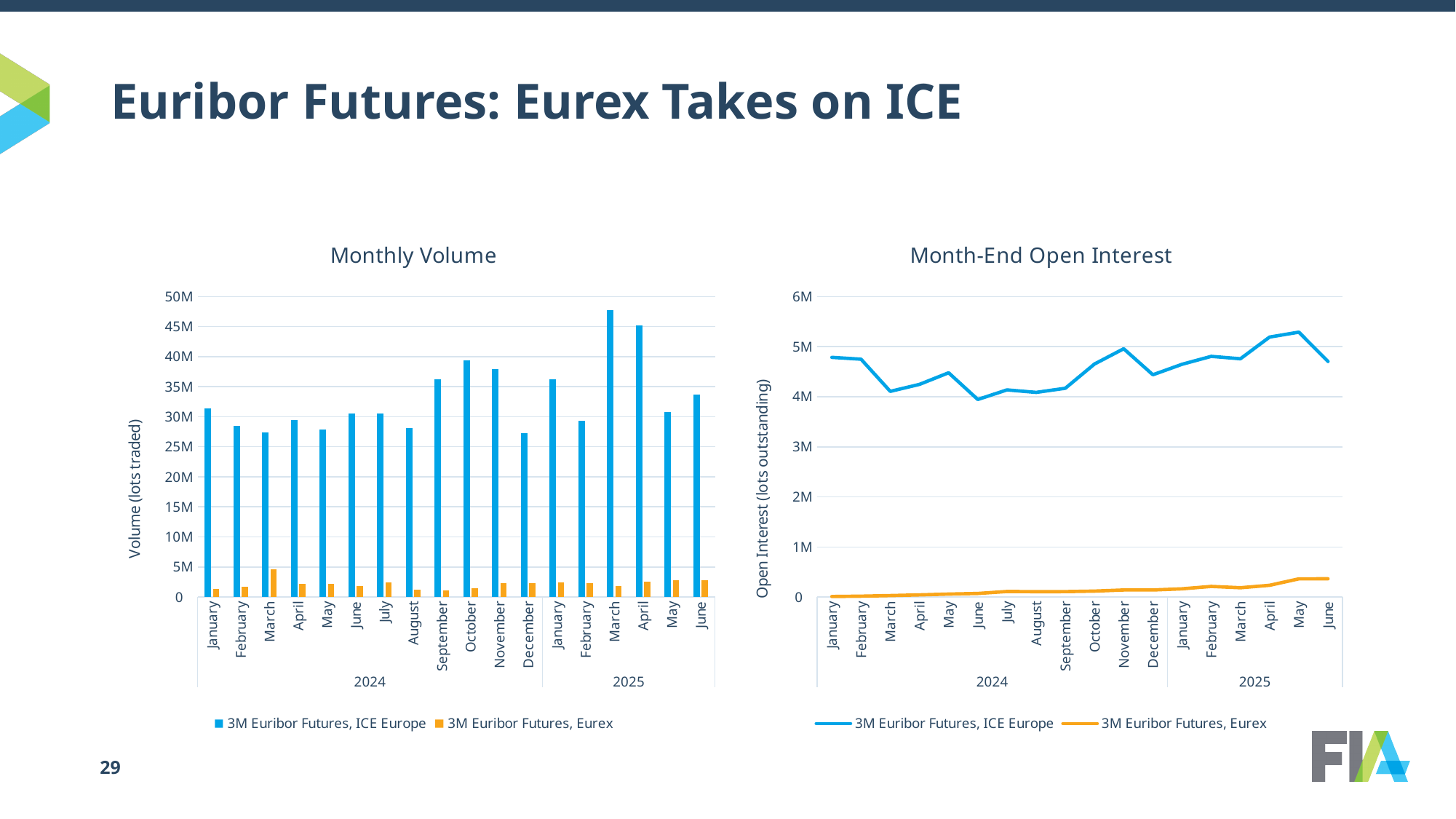
In the Monthly Volume chart, which month has the highest volume for 3M Euribor Futures, ICE Europe? March 2025 How many months are plotted on the Monthly Volume chart? 18 In the Month-End Open Interest chart, which series is larger in June 2025, ICE Europe or Eurex? 3M Euribor Futures, ICE Europe How many series does the legend of the Monthly Volume chart list? 2 In the Month-End Open Interest chart, which month has the highest open interest for 3M Euribor Futures, ICE Europe? May 2025 What kind of chart is the Month-End Open Interest chart? line chart In the Monthly Volume chart, is the ICE Europe volume for March 2025 greater or less than 45M? greater In the Monthly Volume chart, which month has the highest volume for 3M Euribor Futures, Eurex? March 2024 In the Month-End Open Interest chart, is the ICE Europe open interest for May 2025 greater or less than 5M? greater What kind of chart is the Monthly Volume chart? bar chart